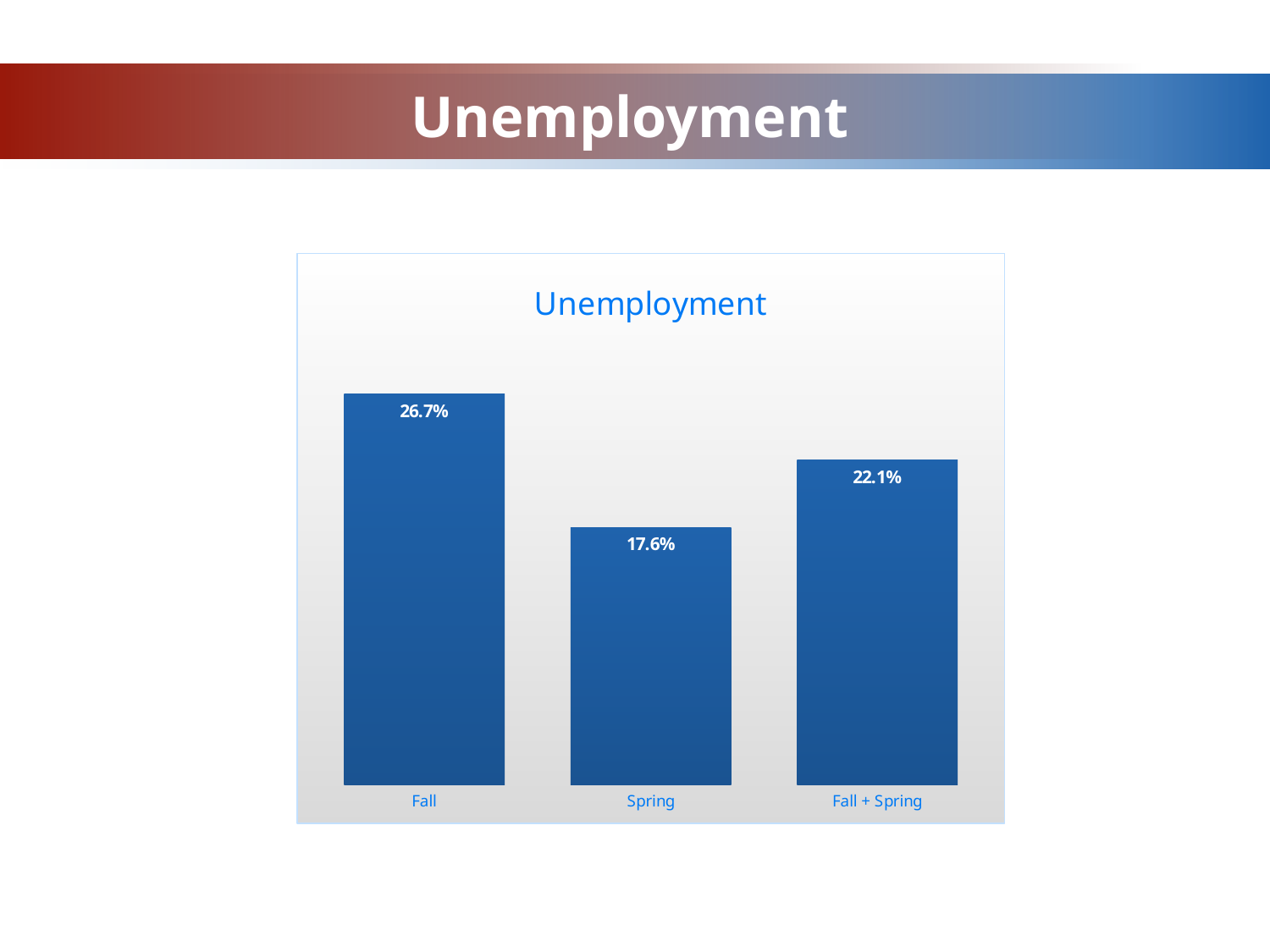
What is the title of the chart? Unemployment What is the difference between the Fall and Spring unemployment values? 9.1% What is the unemployment value for Fall? 26.7% What is the unemployment value for Fall + Spring? 22.1% What is the difference between the Fall and Fall + Spring unemployment values? 4.6% What is the unemployment value for Spring? 17.6% What colour are the bars in the chart? Blue Which category has the highest unemployment value? Fall How many categories are shown in the chart? 3 Which category has the lowest unemployment value? Spring Which is larger, the unemployment value for Spring or for Fall + Spring? Fall + Spring What kind of chart is shown on the slide? Bar chart